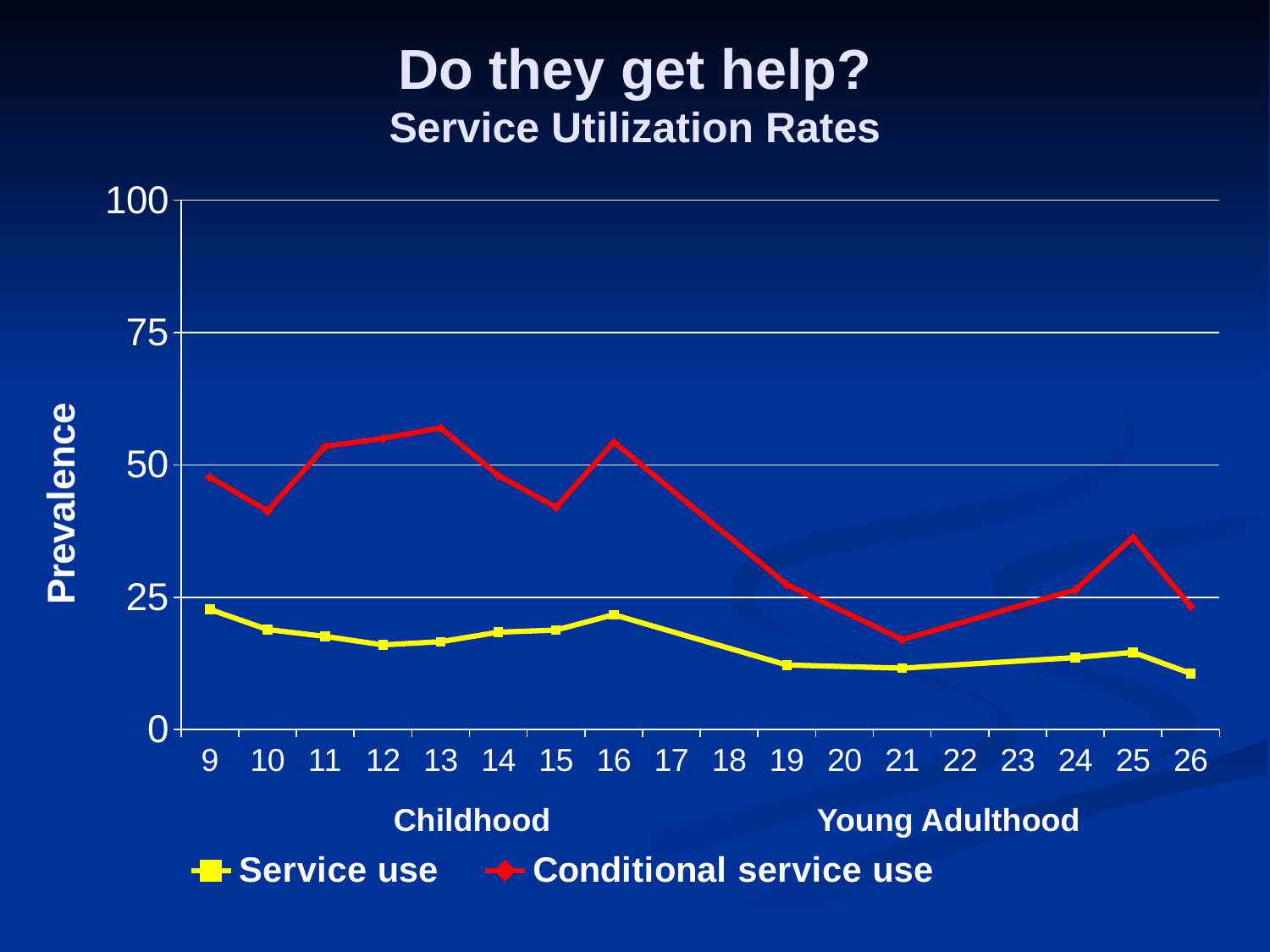
At which age is the Service use value highest? 9 How many age labels are shown along the x axis? 18 Is the Service use value at age 9 greater or less than 25? less Is the Conditional service use value at age 13 greater or less than 50? greater Is the Conditional service use value at age 25 greater or less than 25? greater What kind of chart is shown on the slide? line chart What is the label on the y axis? Prevalence What are the two series named in the legend? Service use and Conditional service use Which series has the larger value at age 16, Service use or Conditional service use? Conditional service use How many series does the legend list? 2 At which age is the Conditional service use value lowest? 21